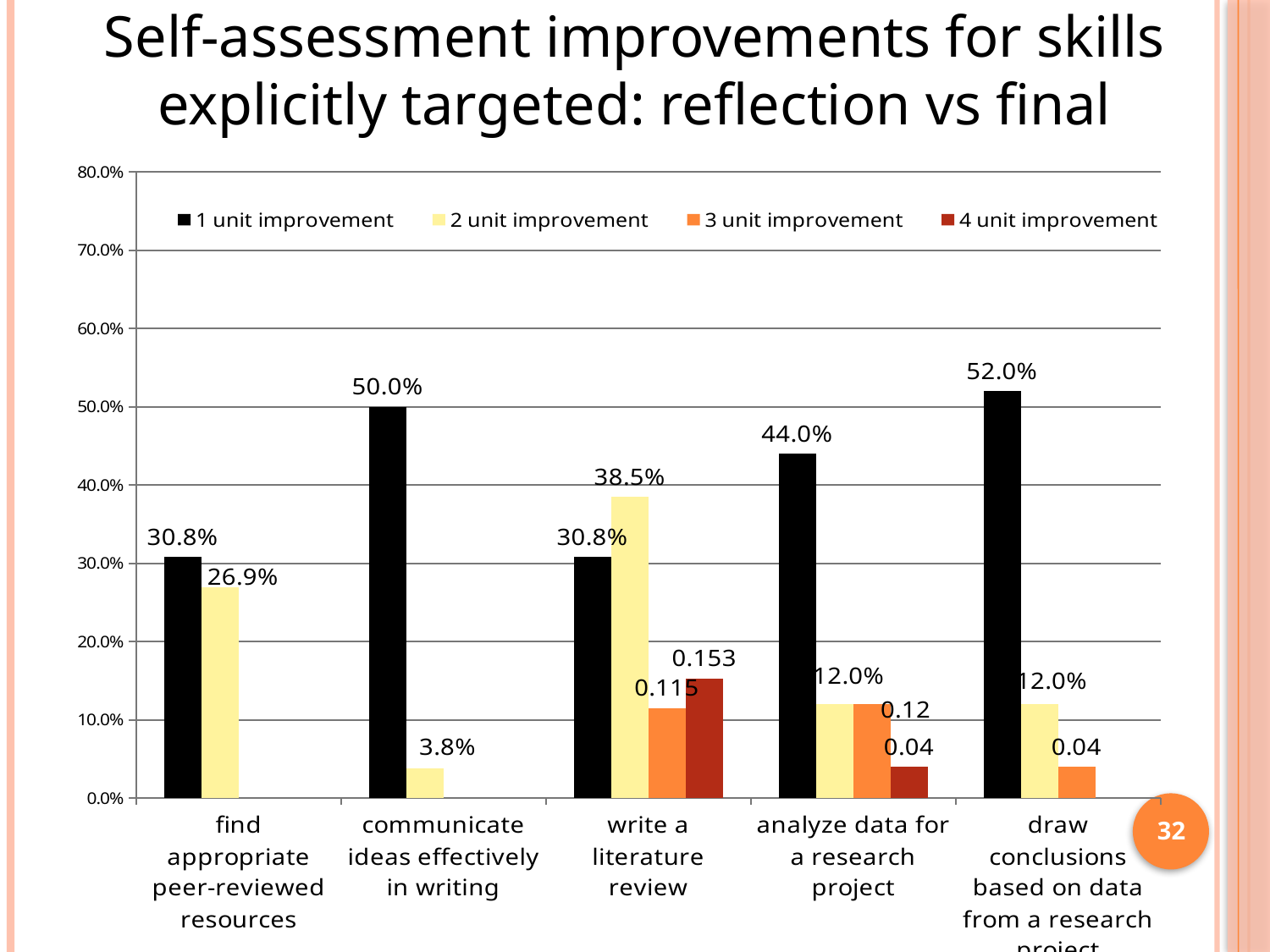
For "write a literature review", which is larger: the 1 unit improvement or the 2 unit improvement? 2 unit improvement Which category has the highest 1 unit improvement value? draw conclusions based on data from a research project What is the value of the 3 unit improvement bar for "analyze data for a research project"? 0.12 What is the value of the 2 unit improvement bar for "write a literature review"? 38.5% Which category has the lowest 2 unit improvement value? communicate ideas effectively in writing How many skill categories are shown on the x axis? 5 What is the value of the 1 unit improvement bar for "communicate ideas effectively in writing"? 50.0% What colour represents the 1 unit improvement series? black How many series does the legend list? 4 What kind of chart is shown on the slide? bar chart What is the difference between the 1 unit improvement values for "draw conclusions based on data from a research project" and "analyze data for a research project"? 8.0% What is the value of the 4 unit improvement bar for "write a literature review"? 0.153